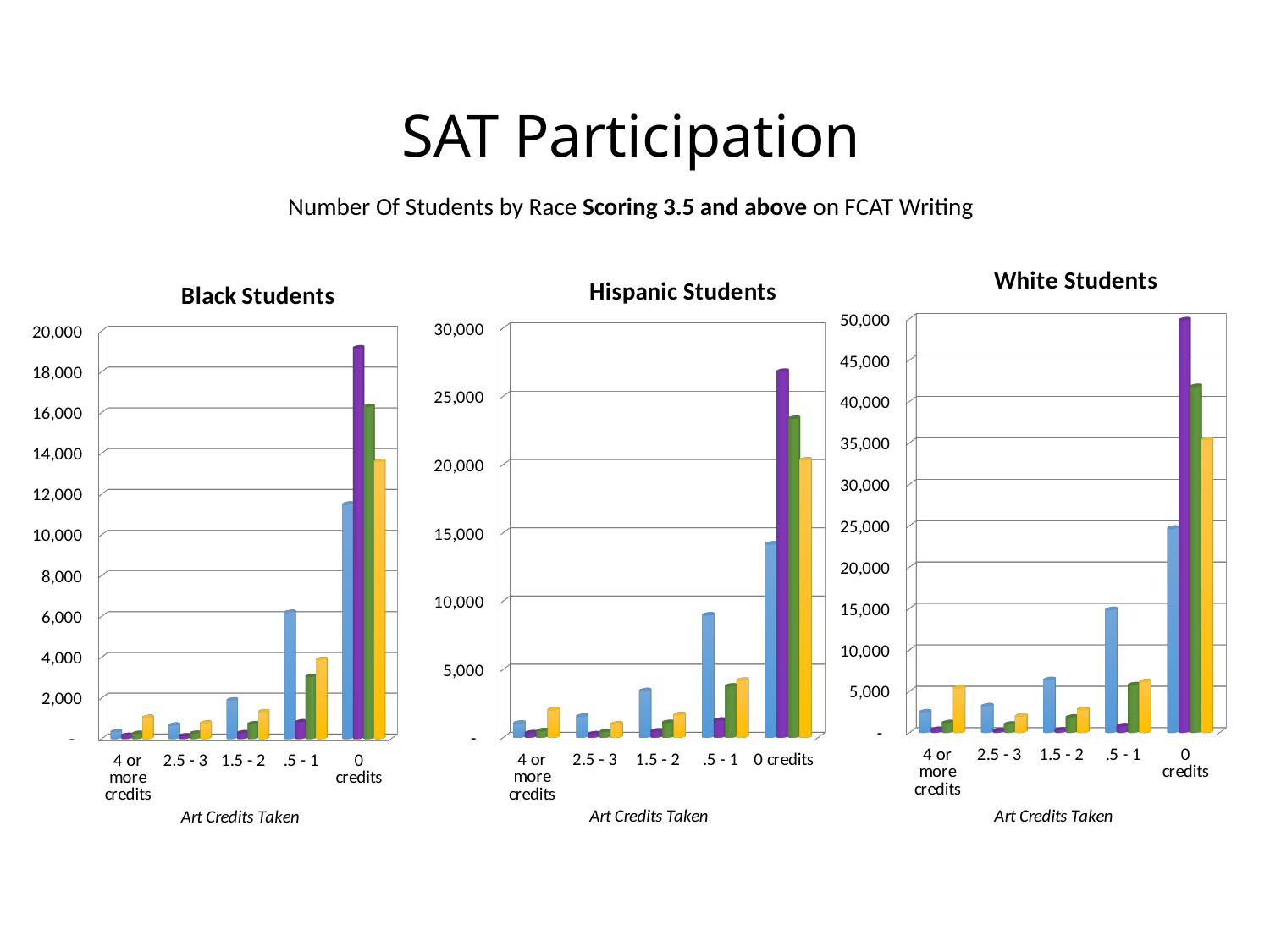
In the Hispanic Students chart, is the tallest bar in the 0 credits group greater or less than 25,000? greater In the White Students chart, which art-credit category has the tallest bars? 0 credits In the White Students chart, is the tallest bar in the .5 - 1 credits group greater or less than 10,000? greater In the White Students chart, is the tallest bar in the 0 credits group greater or less than 45,000? greater What kind of chart is the Black Students chart? bar chart How many art-credit categories are shown on the x axis of the Hispanic Students chart? 5 In the Black Students chart, which art-credit category has the tallest bars? 0 credits In the Black Students chart, do the bar heights generally rise or fall moving from '4 or more credits' to '0 credits' along the x axis? rise What is the x-axis label shown under each of the three charts? Art Credits Taken How many charts are shown on the slide? 3